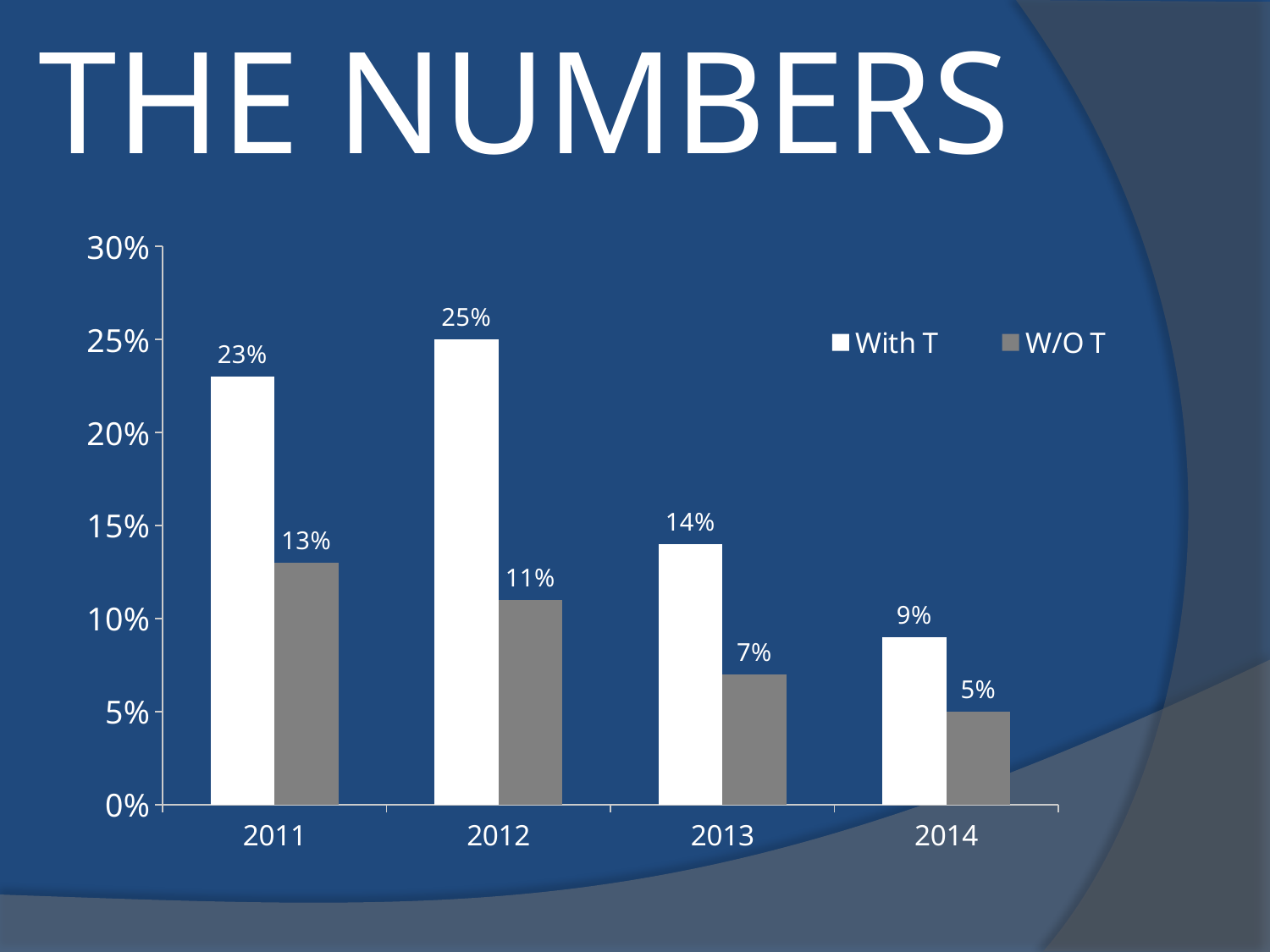
What is the difference between the With T values for 2012 and 2014? 16% What is the value for W/O T in 2013? 7% Which year has the highest With T value? 2012 What kind of chart is shown on the slide? Bar chart What is the value for W/O T in 2011? 13% Which year has the lowest W/O T value? 2014 What is the difference between With T and W/O T in 2011? 10% Do the W/O T values rise or fall from 2011 to 2014? Fall How many series does the legend list? 2 What is the value for With T in 2012? 25% Which is larger in 2013, With T or W/O T? With T How many years are shown on the x axis? 4